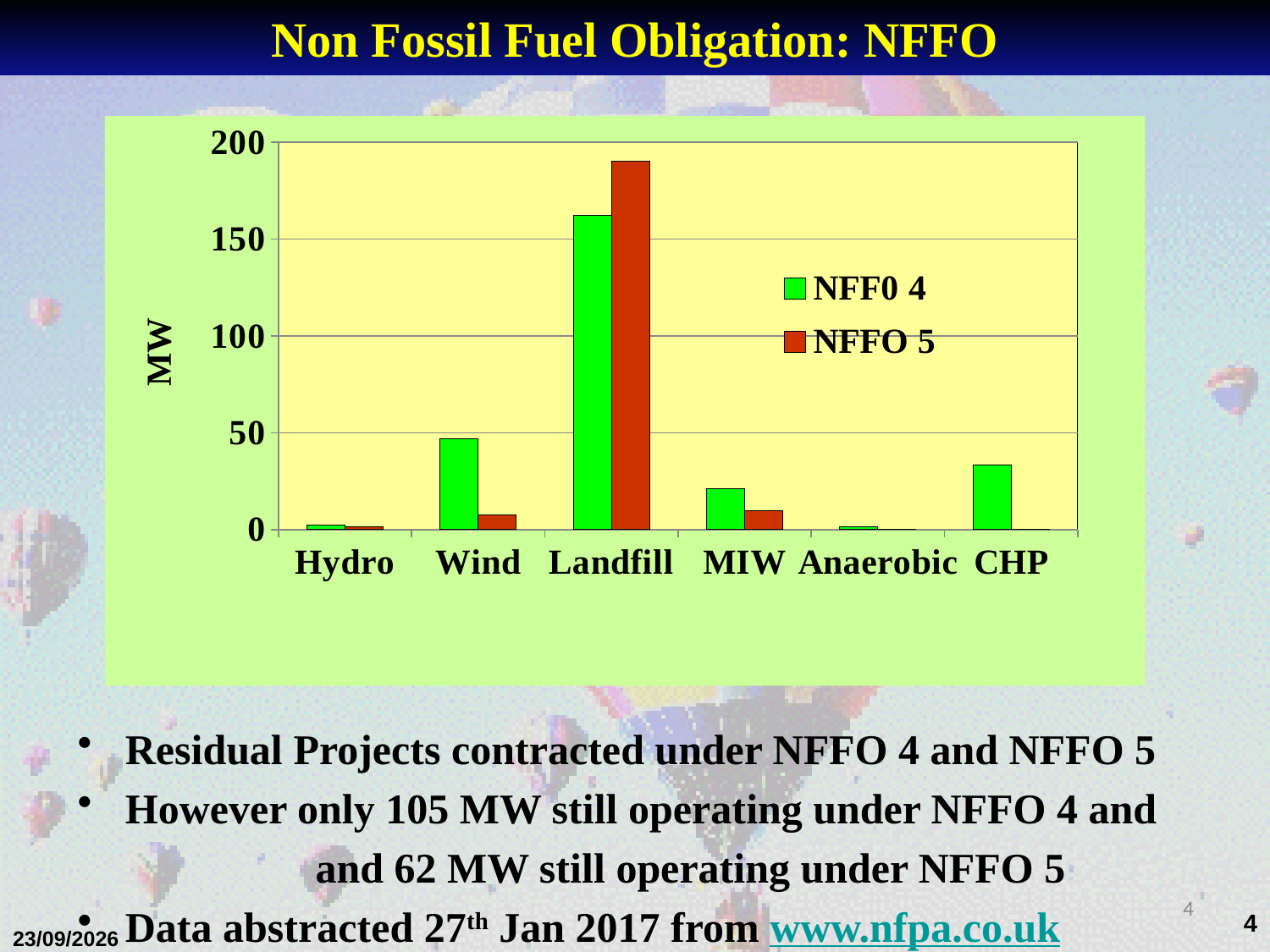
What is the label on the chart's vertical axis? MW For Landfill, which series has the larger value, NFF0 4 or NFFO 5? NFFO 5 Which category has the highest NFF0 4 value? Landfill How many series does the chart's legend list? 2 For Wind, which series has the larger value, NFF0 4 or NFFO 5? NFF0 4 Is the NFF0 4 value for CHP greater or less than 50? less Which category has the highest NFFO 5 value? Landfill Is the NFFO 5 value for Landfill greater or less than 150? greater What kind of chart is shown on the slide? bar chart Is the NFF0 4 value for Landfill greater or less than 150? greater How many categories are shown on the x axis of the chart? 6